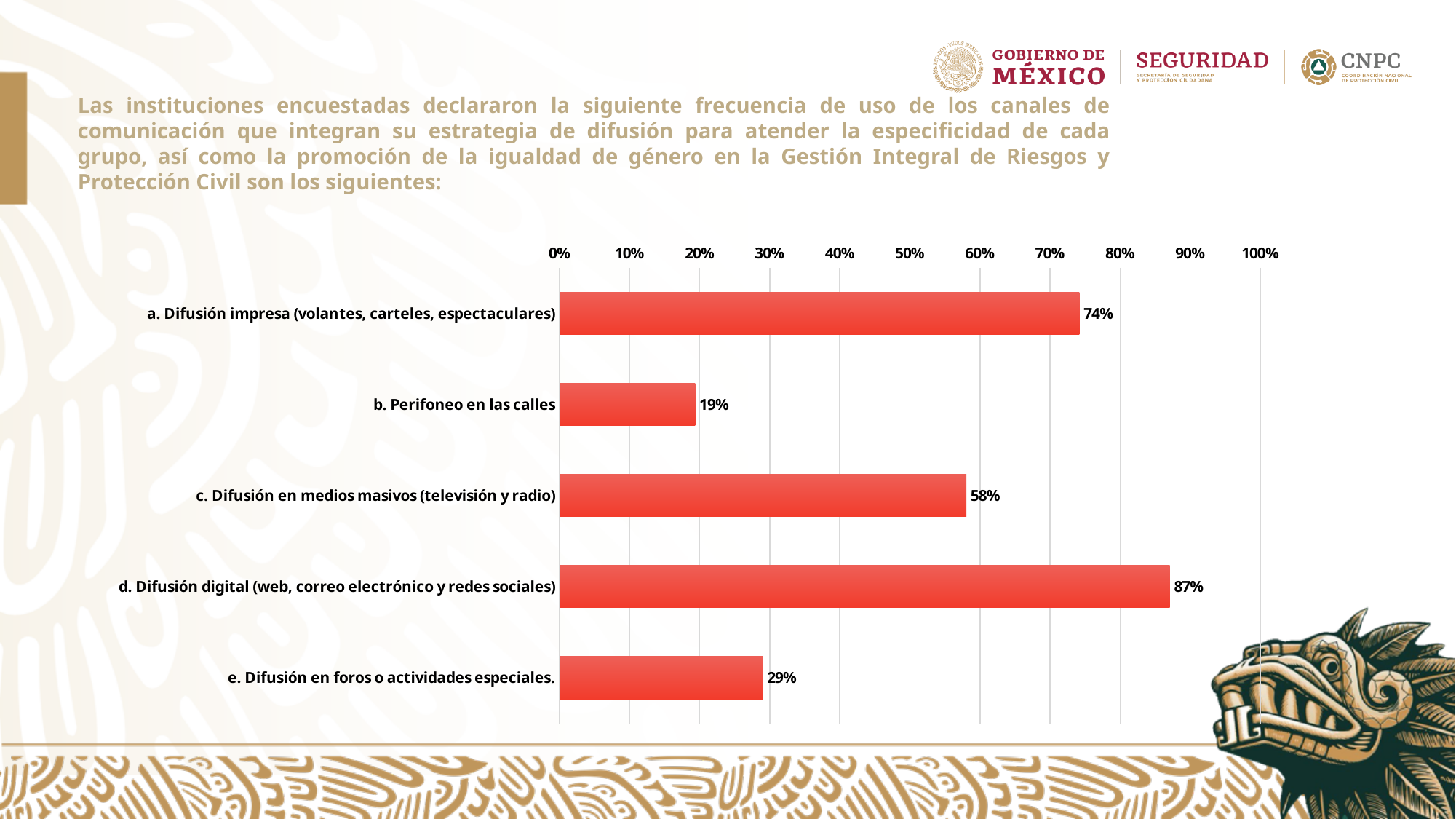
How many categories are shown in the chart? 5 Is the value for "a. Difusión impresa (volantes, carteles, espectaculares)" greater or less than 70%? greater What is the value for "b. Perifoneo en las calles"? 19% Which category has the highest value? d. Difusión digital (web, correo electrónico y redes sociales) Which is larger: the value for "c. Difusión en medios masivos" or "e. Difusión en foros o actividades especiales"? c. Difusión en medios masivos (televisión y radio) What is the maximum value shown on the percentage axis? 100% What is the value for "d. Difusión digital (web, correo electrónico y redes sociales)"? 87% What is the value for "e. Difusión en foros o actividades especiales."? 29% What is the difference between the values for "d. Difusión digital" and "a. Difusión impresa"? 13% Which category has the lowest value? b. Perifoneo en las calles What is the value for "c. Difusión en medios masivos (televisión y radio)"? 58% What kind of chart is shown on the slide? Bar chart